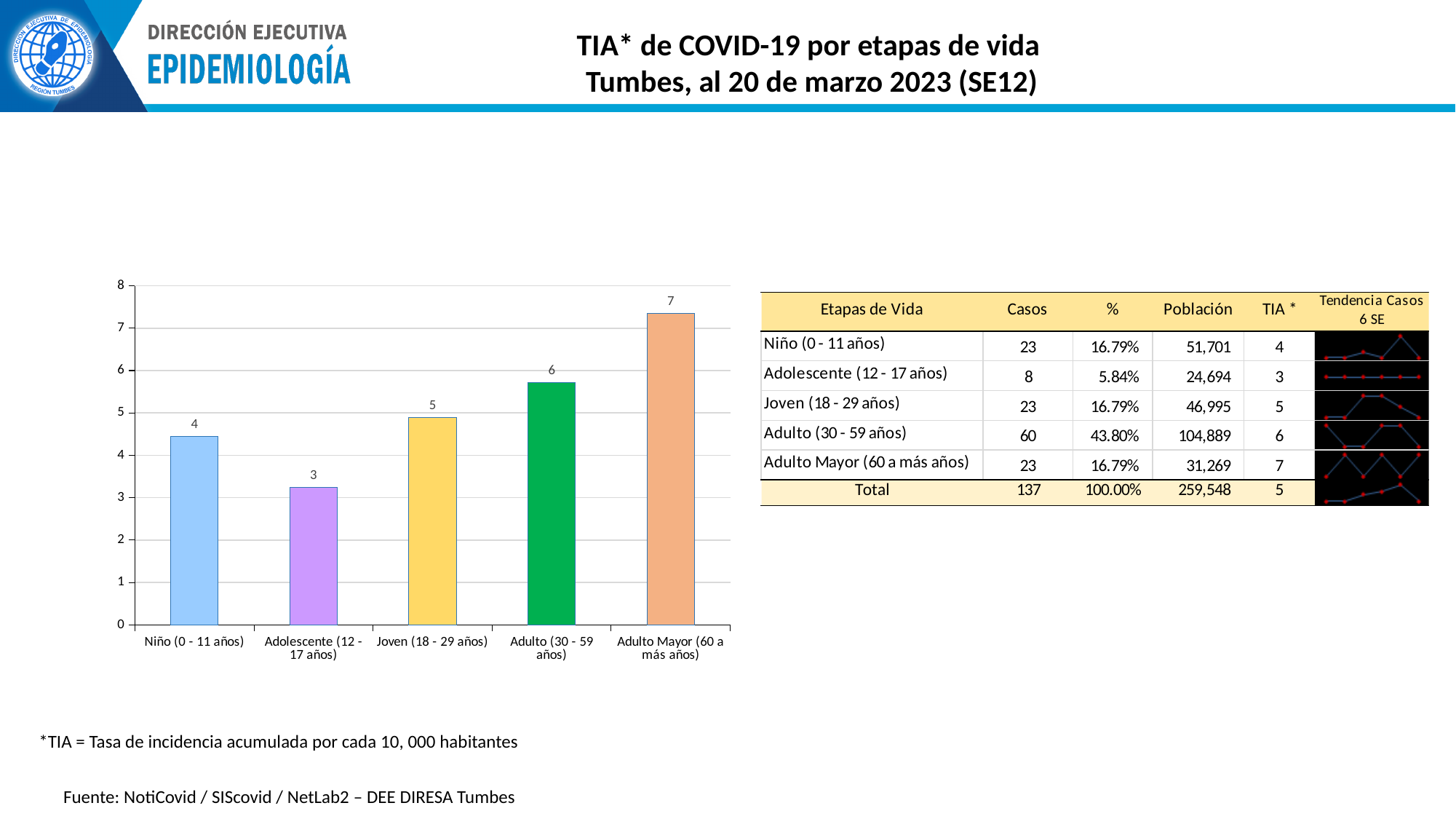
What type of chart is shown on the slide? bar chart Which category has the highest bar in the chart? Adulto Mayor (60 a más años) What is the difference between the labelled values for Adulto Mayor (60 a más años) and Adolescente (12 - 17 años)? 4 Is the bar for Adulto (30 - 59 años) greater or less than 5 on the y axis? greater What is the value labelled on the bar for Niño (0 - 11 años)? 4 Which category has the lowest bar in the chart? Adolescente (12 - 17 años) What is the value labelled on the bar for Adulto Mayor (60 a más años)? 7 What is the value labelled on the bar for Joven (18 - 29 años)? 5 Which has a larger value, Niño (0 - 11 años) or Joven (18 - 29 años)? Joven (18 - 29 años) What is the value labelled on the bar for Adolescente (12 - 17 años)? 3 What is the value labelled on the bar for Adulto (30 - 59 años)? 6 How many categories (etapas de vida) are plotted in the bar chart? 5